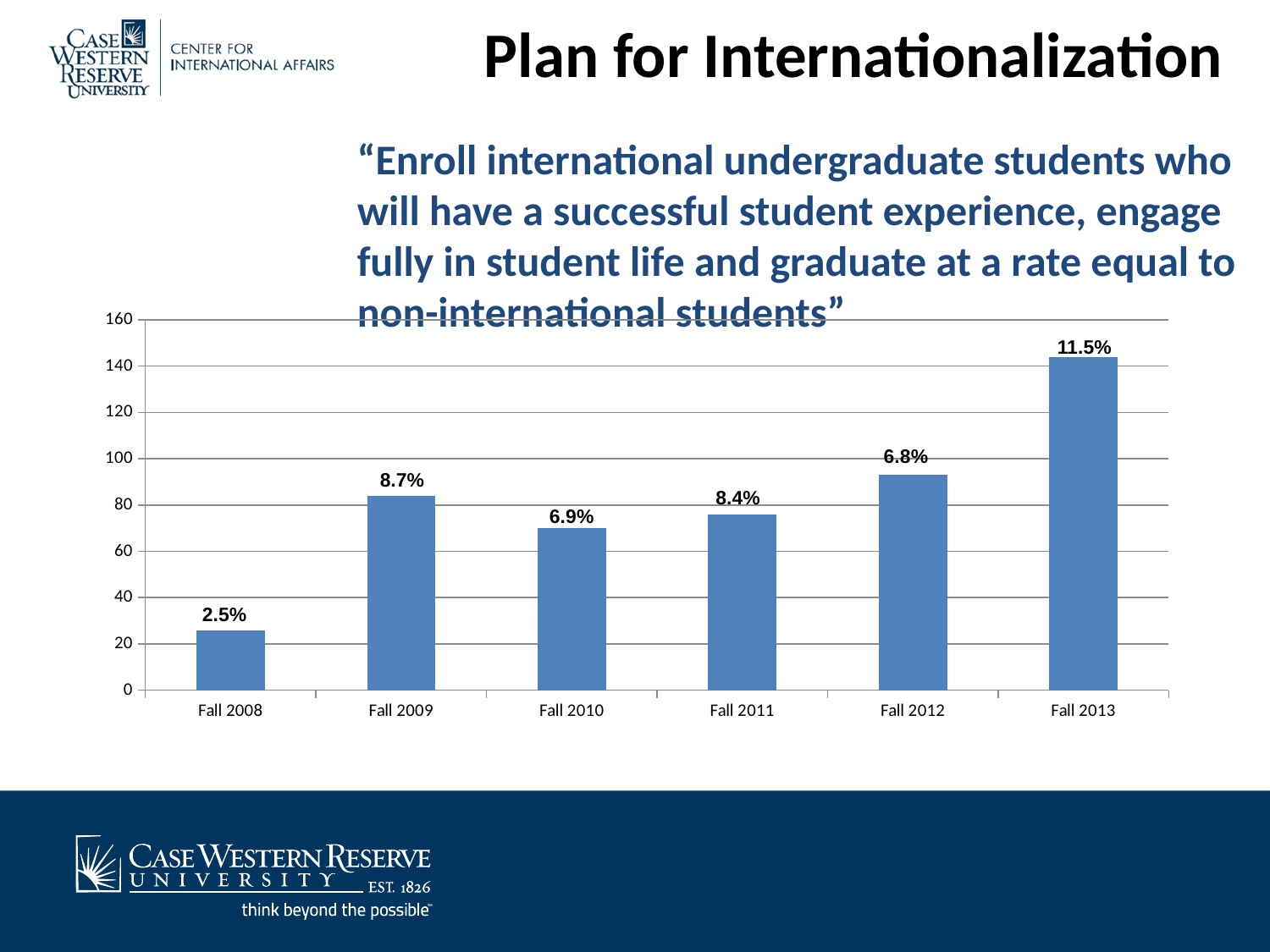
Which bar is taller, Fall 2009 or Fall 2010? Fall 2009 Is the bar for Fall 2013 greater or less than 120 on the vertical axis? greater Do the bars rise or fall from Fall 2011 to Fall 2013? rise Which category has the tallest bar? Fall 2013 What data label is shown above the Fall 2011 bar? 8.4% What data label is shown above the Fall 2008 bar? 2.5% Which category has the shortest bar? Fall 2008 What data label is shown above the Fall 2013 bar? 11.5% Is the bar for Fall 2008 greater or less than 40 on the vertical axis? less How many categories are shown on the x axis? 6 What data label is shown above the Fall 2012 bar? 6.8% What kind of chart is shown on the slide? bar chart